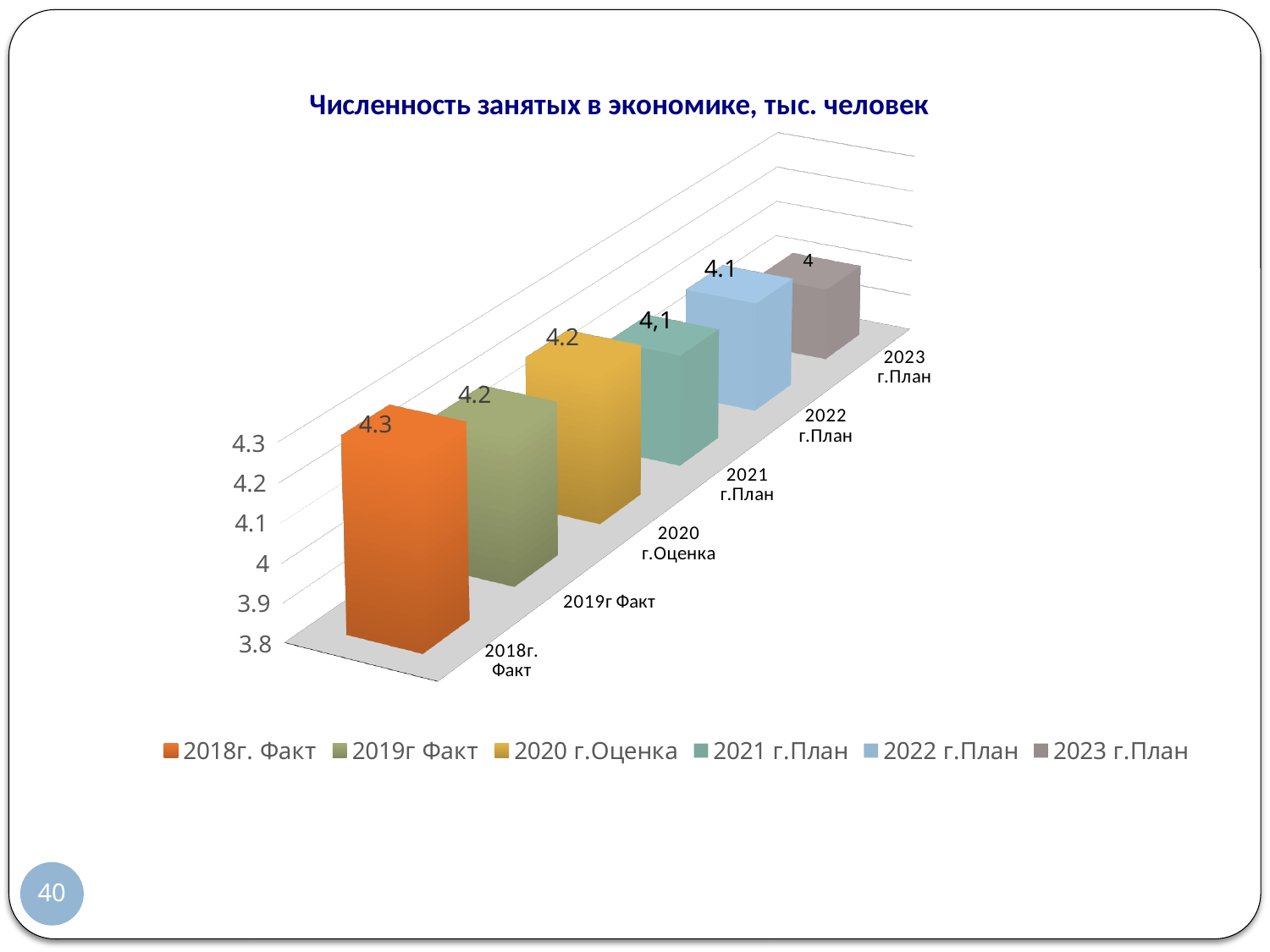
Do the values rise or fall from 2018г. Факт to 2023 г.План? Fall How many categories are shown in the chart? 6 What is the value for 2020 г.Оценка? 4.2 What kind of chart is shown on the slide? Bar chart Which is larger, the value for 2019г Факт or the value for 2022 г.План? 2019г Факт What is the value for 2018г. Факт? 4.3 How many entries does the legend list? 6 What is the difference between the values for 2018г. Факт and 2023 г.План? 0.3 What is the value for 2022 г.План? 4.1 What is the value for 2023 г.План? 4 Which category has the lowest value? 2023 г.План Which category has the highest value? 2018г. Факт